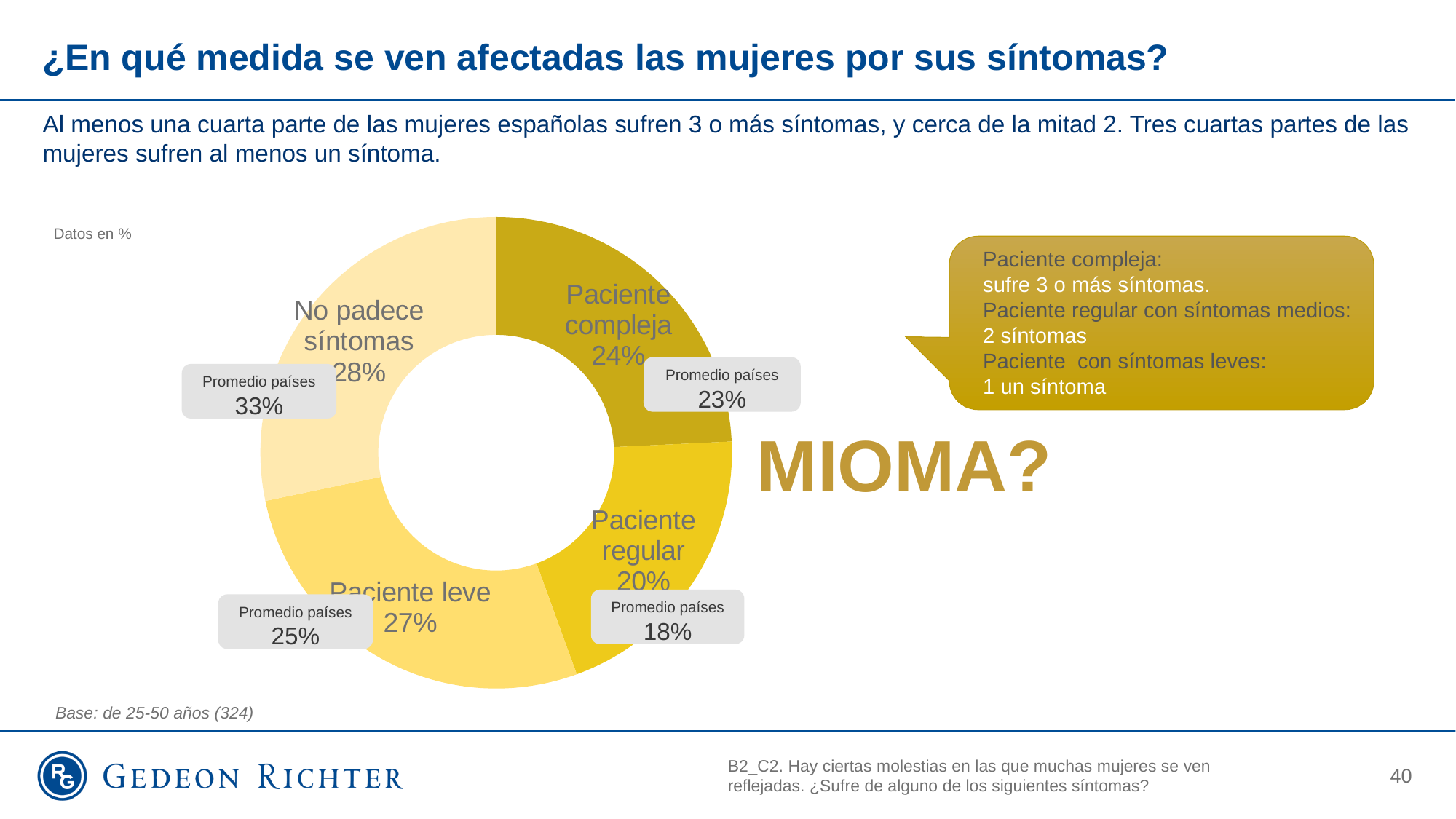
Which segment of the donut chart has the smallest share? Paciente regular What percentage of the donut chart is labelled "No padece síntomas"? 28% What kind of chart is shown on the slide? Donut (pie) chart What is the "Promedio países" value shown next to the "Paciente regular" segment? 18% What percentage of the donut chart is labelled "Paciente compleja"? 24% What is the difference in percentage points between "No padece síntomas" and "Paciente regular" in the donut chart? 8 What percentage of the donut chart is labelled "Paciente leve"? 27% Which is larger in the donut chart, "Paciente leve" or "Paciente compleja"? Paciente leve How many segments does the donut chart have? 4 What is the "Promedio países" value shown next to the "No padece síntomas" segment? 33% Which segment of the donut chart has the largest share? No padece síntomas What percentage of the donut chart is labelled "Paciente regular"? 20%